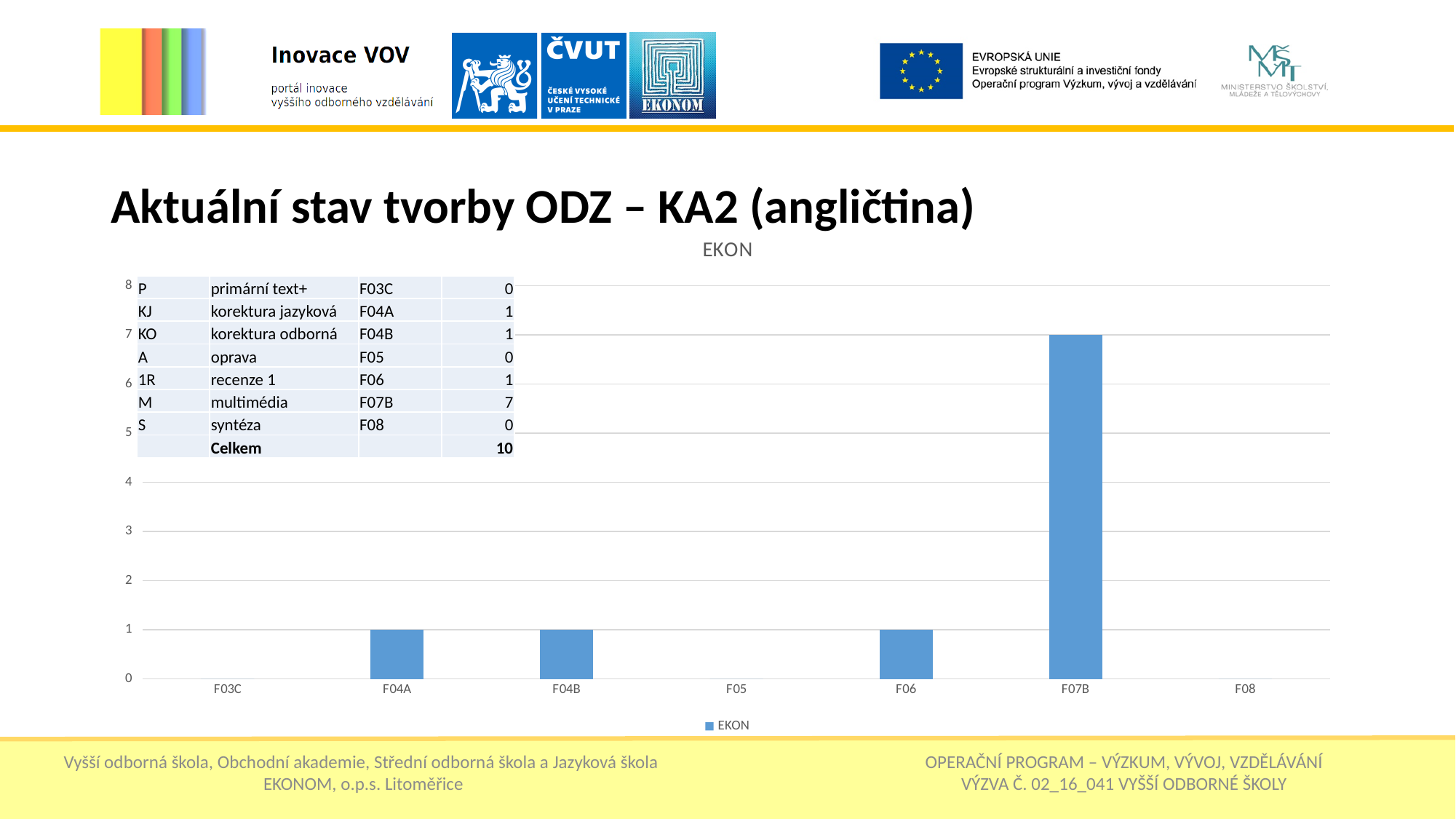
What is the value for F07B? 7 Which category has the highest value in the chart? F07B What is the difference between the values for F07B and F06? 6 What is the total (Celkem) of all values shown in the table on the chart? 10 Is the value for F07B greater or less than 5? greater How many series does the chart legend list? 1 What is the title of the chart? EKON What is the value for F04A? 1 What is the value for F05? 0 How many categories are shown on the x axis of the chart? 7 Which is larger, the value for F04B or the value for F08? F04B What kind of chart is shown on the slide? bar chart